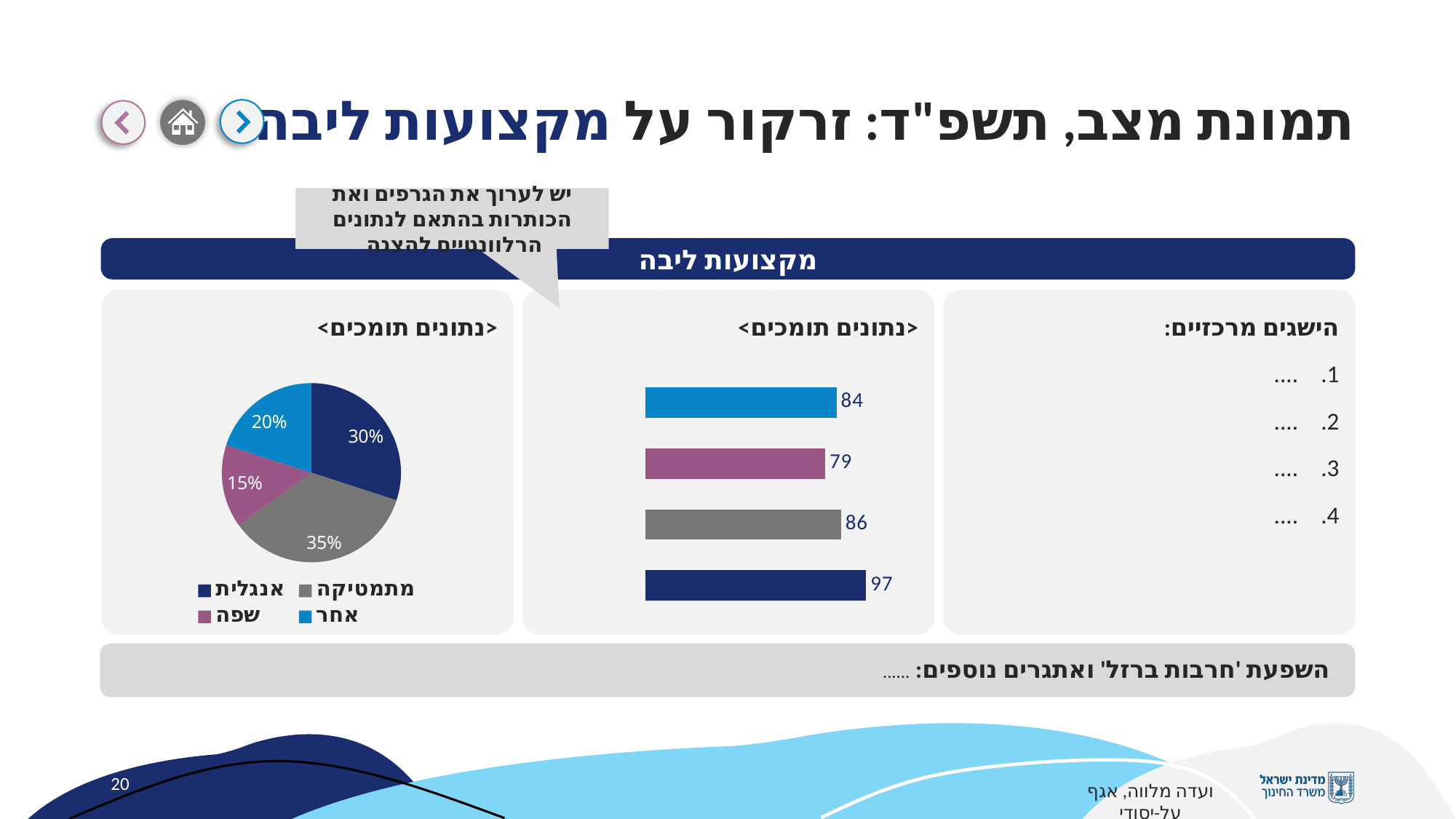
In the pie chart on the left, which category has the smallest slice? שפה In the pie chart on the left, which category has the largest slice? מתמטיקה What kind of chart is the middle chart on the slide? Bar chart In the bar chart in the middle, how many bars are plotted? 4 In the bar chart in the middle, what is the highest value shown? 97 In the pie chart on the left, what share does מתמטיקה have? 35% In the pie chart on the left, what share does אנגלית have? 30% In the pie chart on the left, how many categories does the legend list? 4 In the bar chart in the middle, what is the lowest value shown? 79 In the pie chart on the left, what share does שפה have? 15% In the pie chart on the left, which is larger, the share of אנגלית or the share of אחר? אנגלית In the pie chart on the left, what is the difference between the shares of מתמטיקה and אחר? 15%